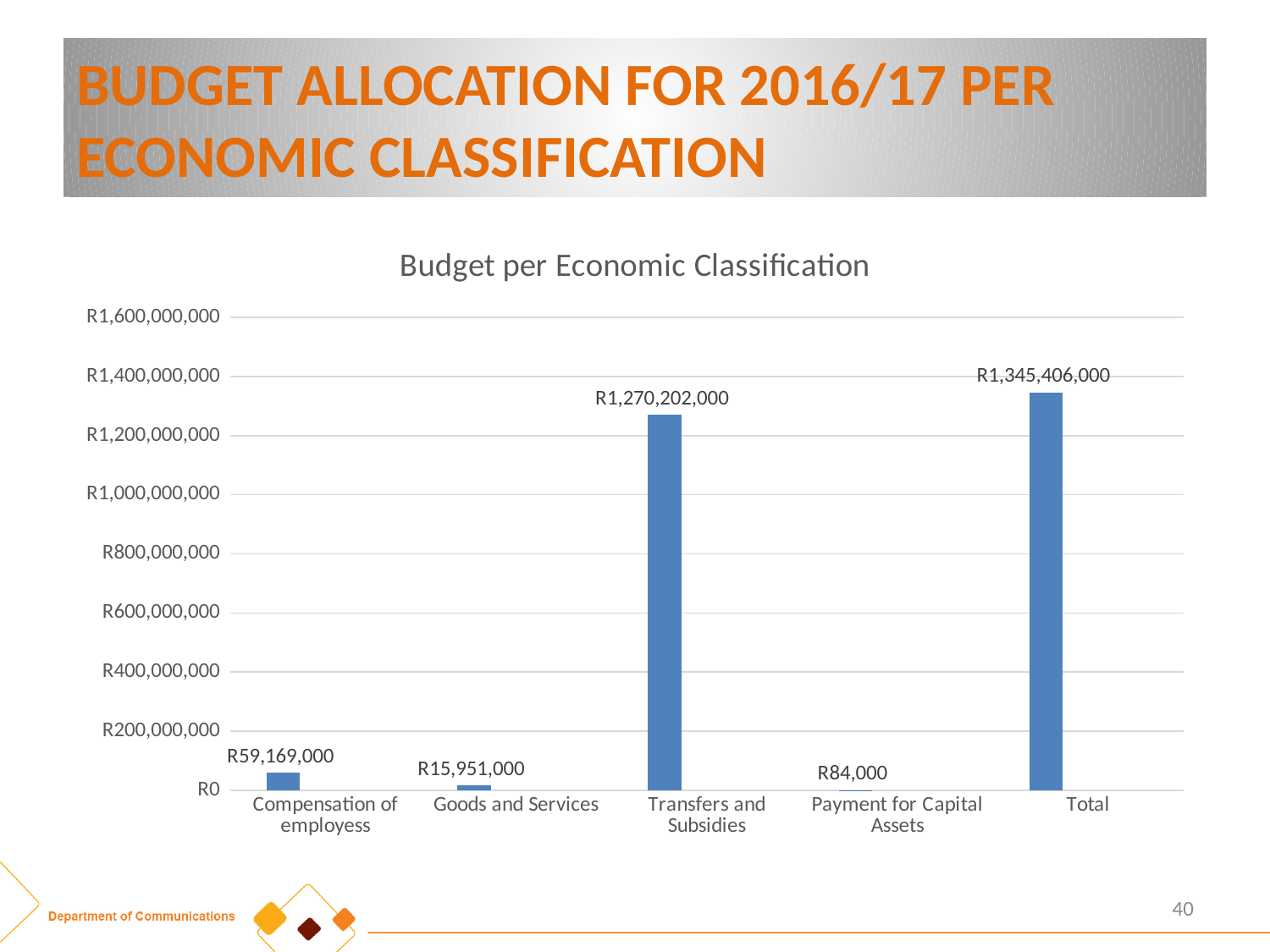
How many categories are shown on the x axis? 5 Is the value for Transfers and Subsidies greater or less than R1,200,000,000? greater Which category has the highest value? Total Which is larger, Compensation of employess or Goods and Services? Compensation of employess What is the value for Goods and Services? R15,951,000 What is the difference between the Total and Transfers and Subsidies? R75,204,000 What is the difference between Compensation of employess and Goods and Services? R43,218,000 What is the value for Compensation of employess? R59,169,000 Which category has the lowest value? Payment for Capital Assets What is the title of the chart? Budget per Economic Classification What is the value for Payment for Capital Assets? R84,000 What is the value for Transfers and Subsidies? R1,270,202,000